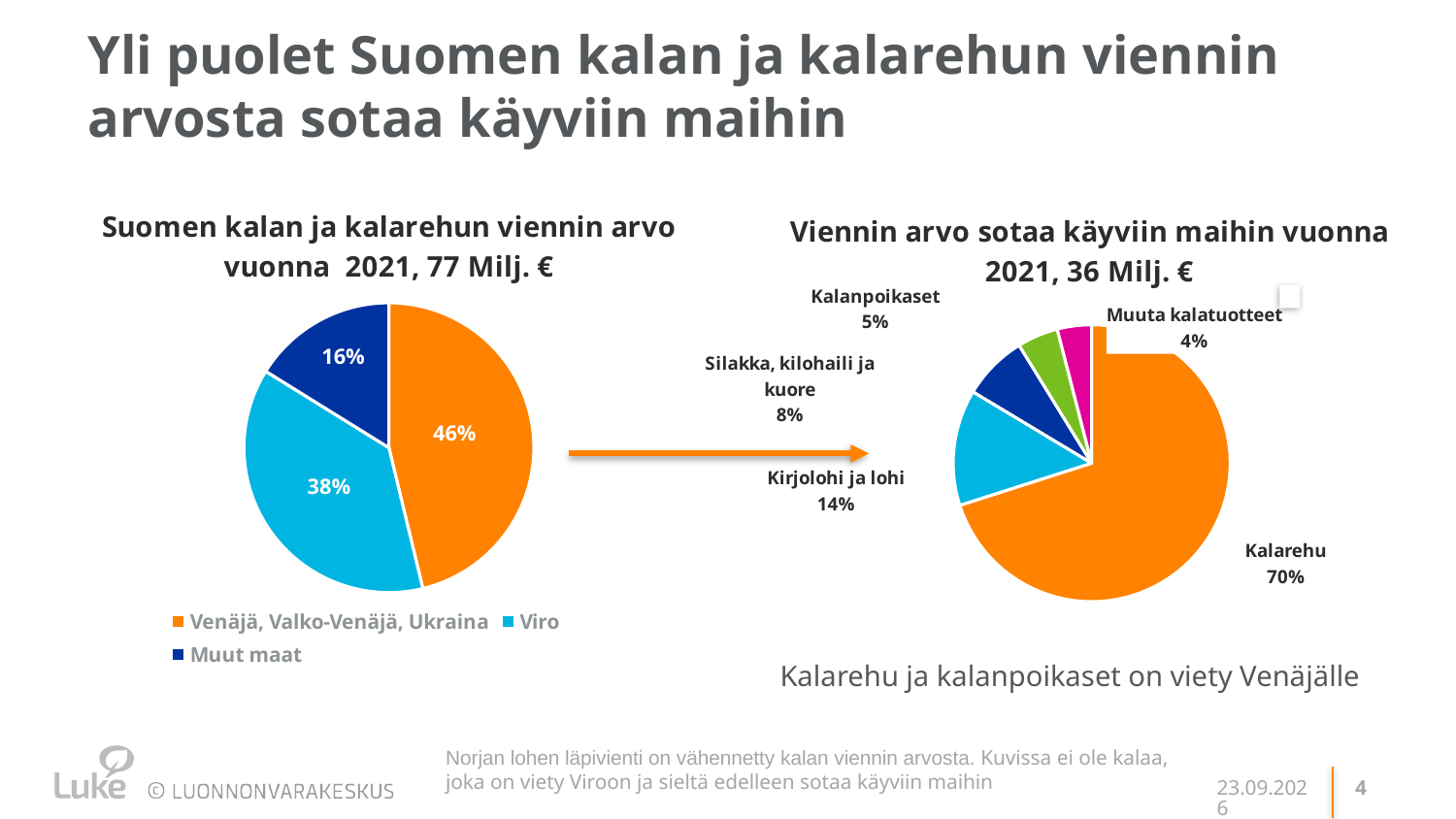
What type of chart is the right chart 'Viennin arvo sotaa käyviin maihin vuonna 2021, 36 Milj. €'? Pie chart In the left chart 'Suomen kalan ja kalarehun viennin arvo vuonna 2021, 77 Milj. €', which category has the smallest share? Muut maat In the left chart 'Suomen kalan ja kalarehun viennin arvo vuonna 2021, 77 Milj. €', what share does Viro have? 38% In the right chart 'Viennin arvo sotaa käyviin maihin vuonna 2021, 36 Milj. €', which category has the smallest share? Muuta kalatuotteet In the left chart 'Suomen kalan ja kalarehun viennin arvo vuonna 2021, 77 Milj. €', what share does 'Venäjä, Valko-Venäjä, Ukraina' have? 46% In the right chart 'Viennin arvo sotaa käyviin maihin vuonna 2021, 36 Milj. €', how many slices are there? 5 In the right chart 'Viennin arvo sotaa käyviin maihin vuonna 2021, 36 Milj. €', what is the difference in percentage points between Kalarehu and 'Kirjolohi ja lohi'? 56 percentage points In the left chart 'Suomen kalan ja kalarehun viennin arvo vuonna 2021, 77 Milj. €', what is the difference in percentage points between 'Venäjä, Valko-Venäjä, Ukraina' and Viro? 8 percentage points In the right chart 'Viennin arvo sotaa käyviin maihin vuonna 2021, 36 Milj. €', which is larger: Kalanpoikaset or 'Silakka, kilohaili ja kuore'? Silakka, kilohaili ja kuore In the left chart 'Suomen kalan ja kalarehun viennin arvo vuonna 2021, 77 Milj. €', how many categories does the legend list? 3 In the right chart 'Viennin arvo sotaa käyviin maihin vuonna 2021, 36 Milj. €', what share does Kalarehu have? 70% In the right chart 'Viennin arvo sotaa käyviin maihin vuonna 2021, 36 Milj. €', what share does 'Kirjolohi ja lohi' have? 14%